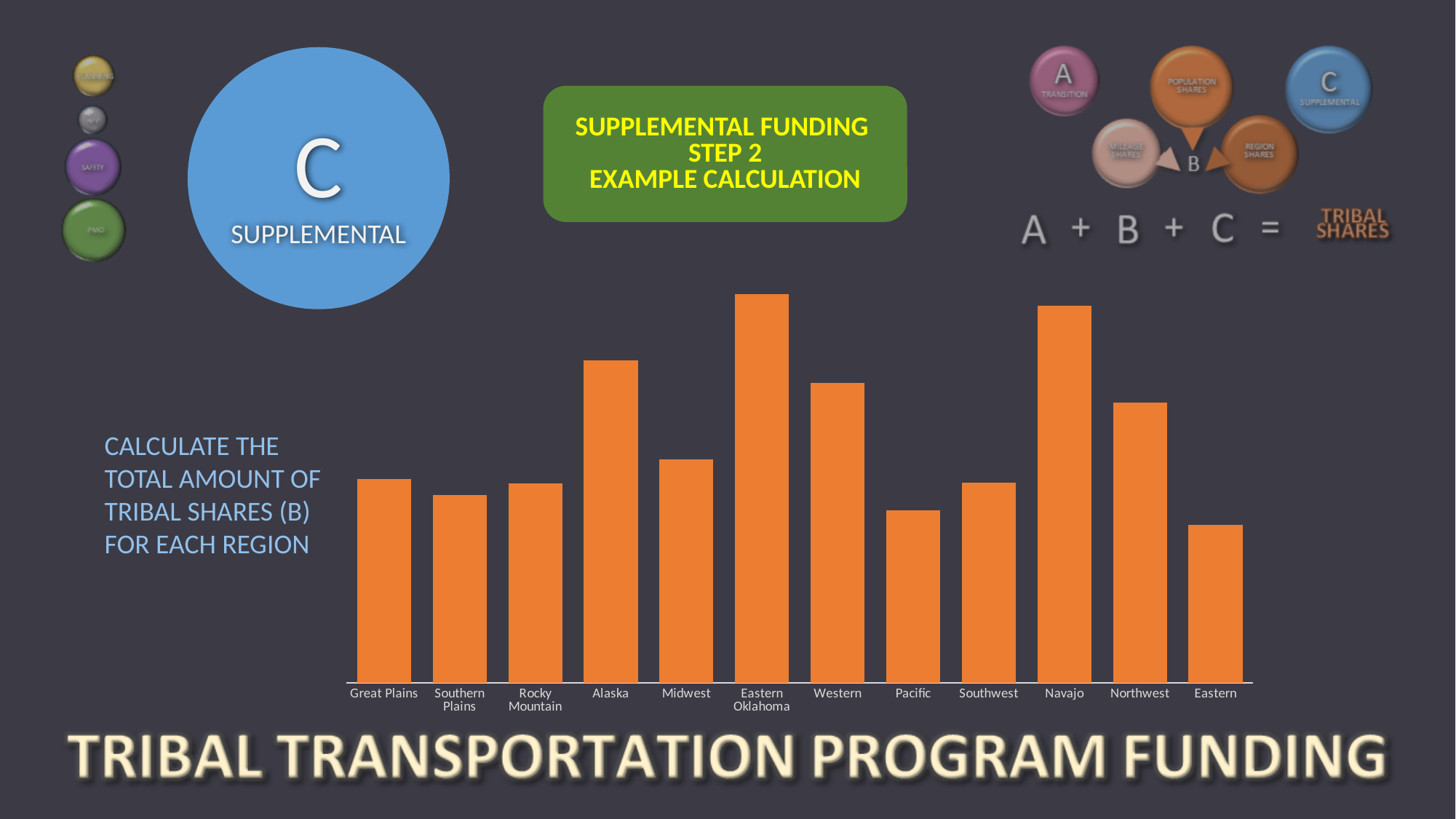
Which region has the tallest bar in the chart? Eastern Oklahoma Which bar is taller, Eastern Oklahoma or Western? Eastern Oklahoma What kind of chart is shown on the slide? bar chart Which bar is taller, Pacific or Southwest? Southwest What colour are the bars in the chart? orange Which bar is taller, Navajo or Northwest? Navajo How many regions are shown on the x axis of the bar chart? 12 What is the label of the first category on the left of the x axis? Great Plains Which region has the shortest bar in the chart? Eastern